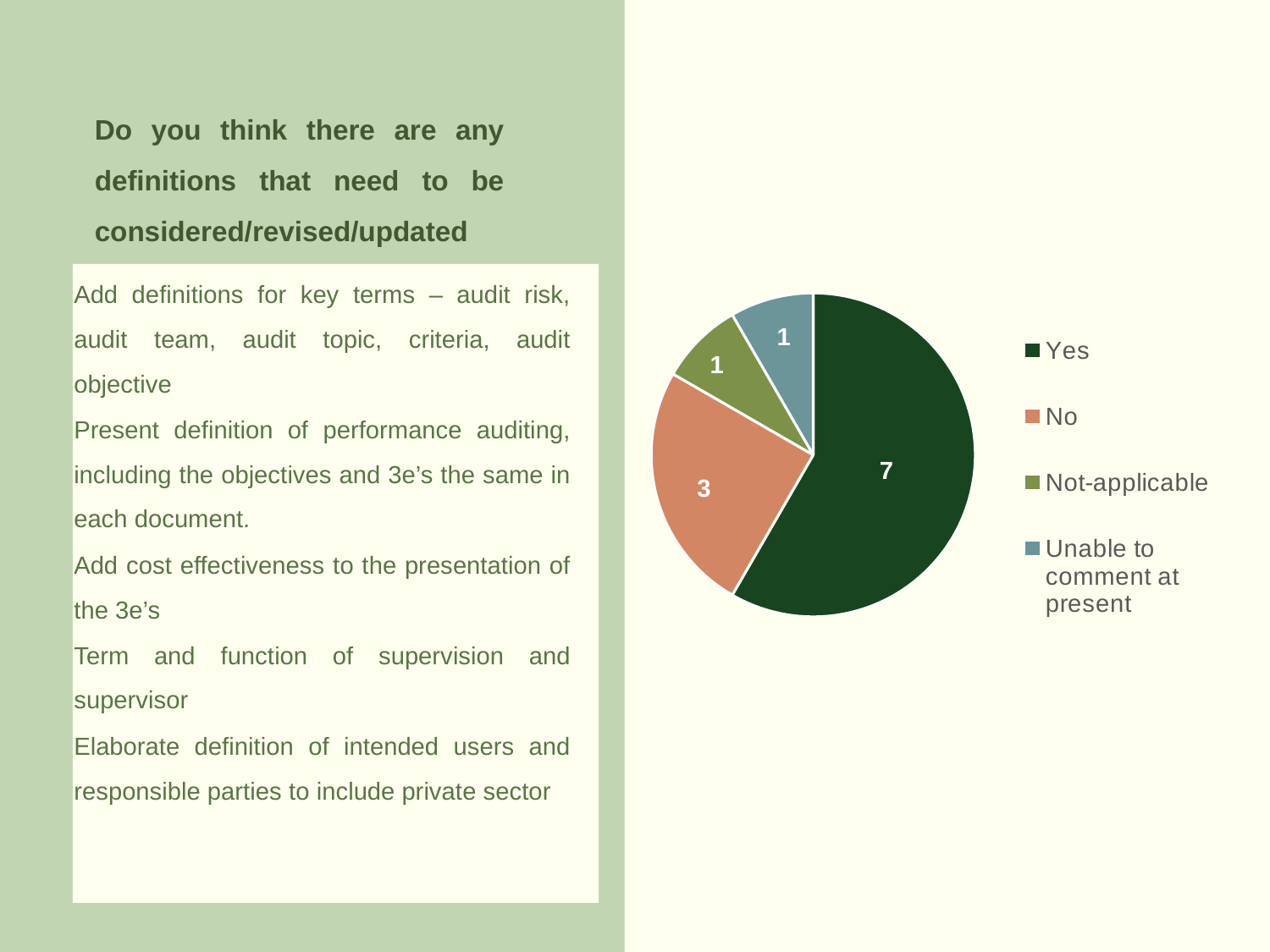
What share of the pie does the "No" slice represent? 25% What is the value for "No" in the pie chart? 3 What is the difference between the values for "Yes" and "No"? 4 What colour is the "Yes" slice in the pie chart? dark green Which is larger, the value for "No" or the value for "Not-applicable"? No How many categories does the pie chart show? 4 Which category has the largest slice in the pie chart? Yes What is the value for "Yes" in the pie chart? 7 What is the value for "Unable to comment at present" in the pie chart? 1 What is the total of all the values in the pie chart? 12 What is the value for "Not-applicable" in the pie chart? 1 What kind of chart is shown on the slide? pie chart